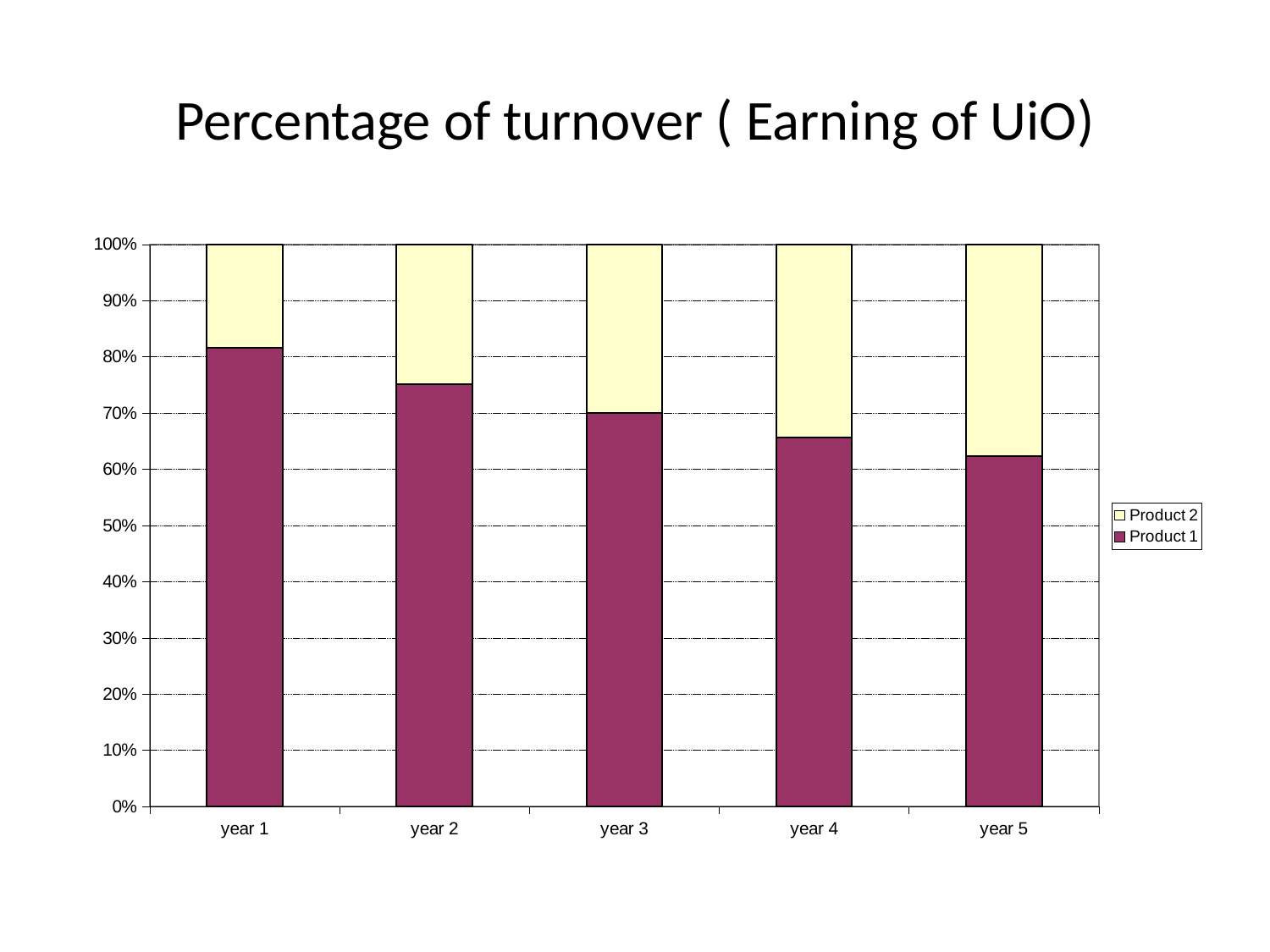
What kind of chart is shown on the slide? stacked bar chart Is the share of Product 1 in year 5 greater or less than 70%? less Which is larger in year 4: the share of Product 1 or the share of Product 2? Product 1 What is the title of the chart on the slide? Percentage of turnover ( Earning of UiO) Which series is shown in the dark purple colour? Product 1 In which year is the share of Product 1 lowest? year 5 Does the share of Product 1 rise or fall from year 1 to year 5? fall Is the share of Product 1 in year 1 greater or less than 80%? greater In which year is the share of Product 1 highest? year 1 In which year is the share of Product 2 largest? year 5 How many years are shown on the x axis of the chart? 5 How many series does the chart's legend list? 2